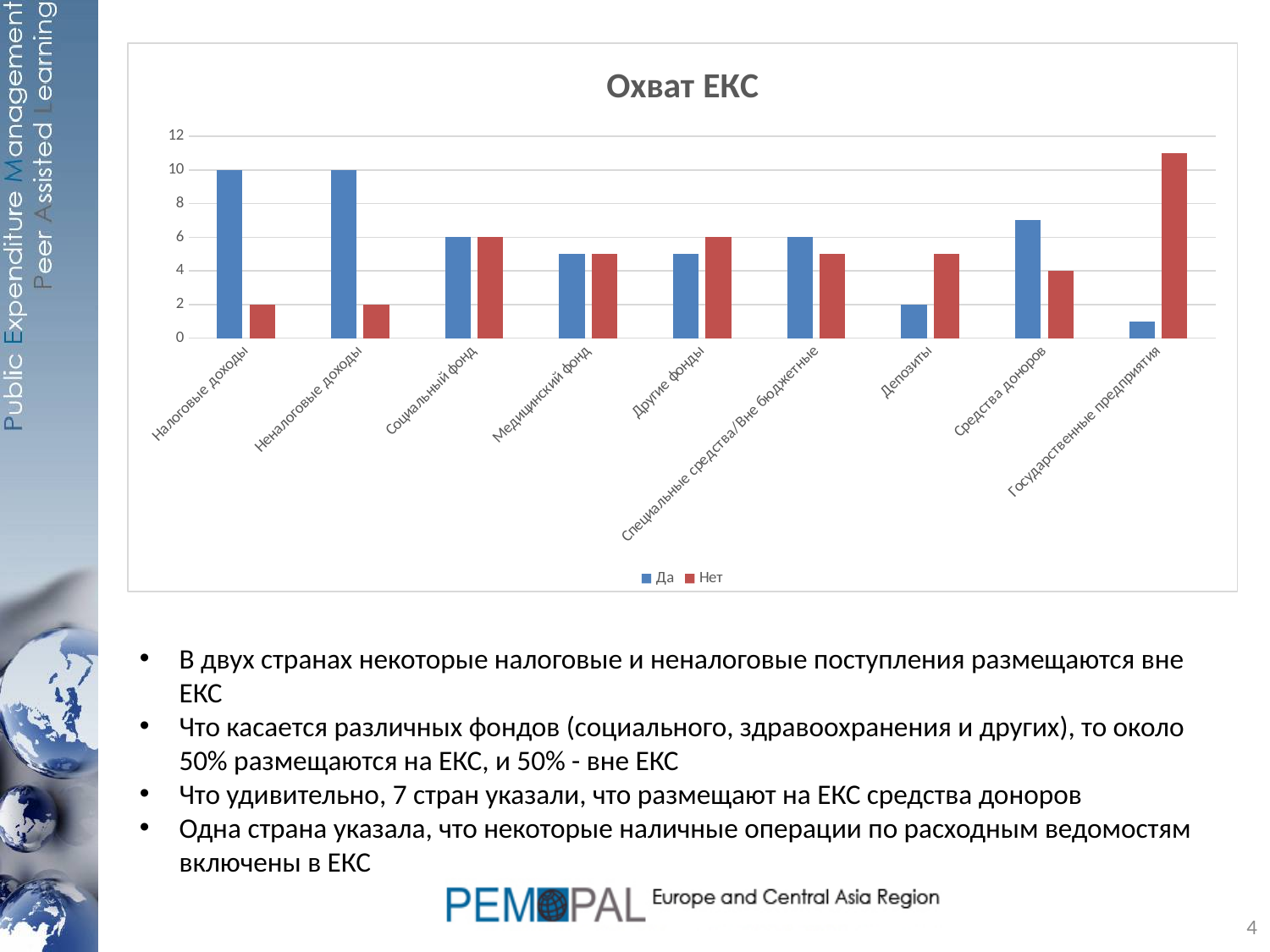
What type of chart is shown on the slide? bar chart Which category has the lowest 'Да' value? Государственные предприятия How many series does the legend list? 2 Which category has the highest 'Нет' value? Государственные предприятия What is the value of the 'Да' series for Социальный фонд? 6 How many categories are shown on the x axis? 9 What is the title of the chart? Охват ЕКС Is the 'Нет' value for Государственные предприятия greater or less than 10? greater What is the value of the 'Нет' series for Неналоговые доходы? 2 For Депозиты, which is larger: the 'Да' value or the 'Нет' value? Нет What is the value of the 'Да' series for Налоговые доходы? 10 What is the value of the 'Нет' series for Средства доноров? 4